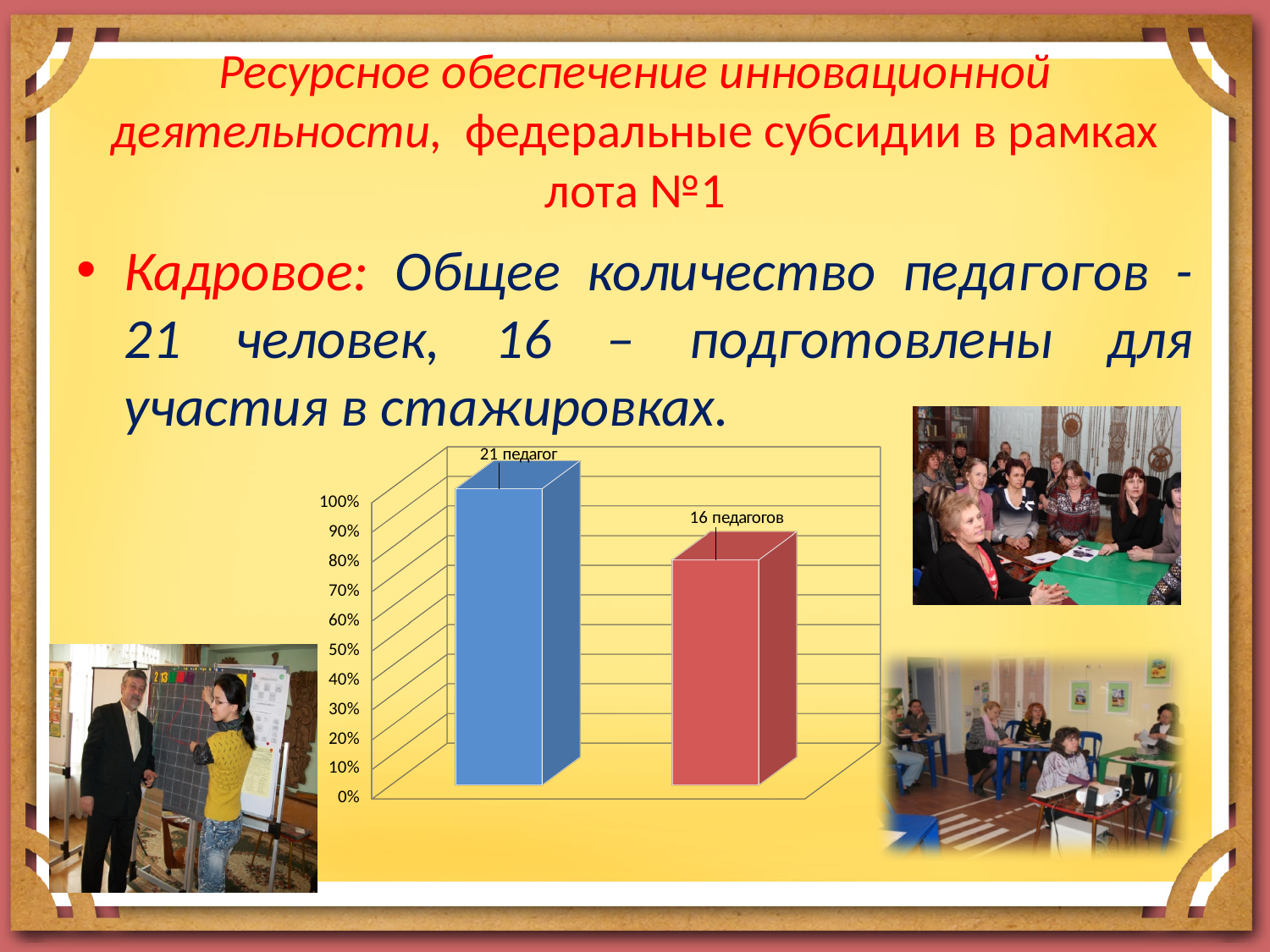
What colour is the bar labelled "16 педагогов"? red How many bars are plotted in the chart? 2 What is the data label on the red bar in the chart? 16 педагогов What kind of chart is shown on the slide? bar chart Is the value of the bar labelled "16 педагогов" greater or less than 60%? greater What is the data label on the blue bar in the chart? 21 педагог Is the value of the bar labelled "21 педагог" greater or less than 90%? greater Which bar is the shortest in the chart? 16 педагогов Which bar is the tallest in the chart? 21 педагог Which bar is taller, the one labelled "21 педагог" or the one labelled "16 педагогов"? 21 педагог What is the highest value shown on the vertical axis of the chart? 100% Is the value of the bar labelled "16 педагогов" greater or less than 90%? less